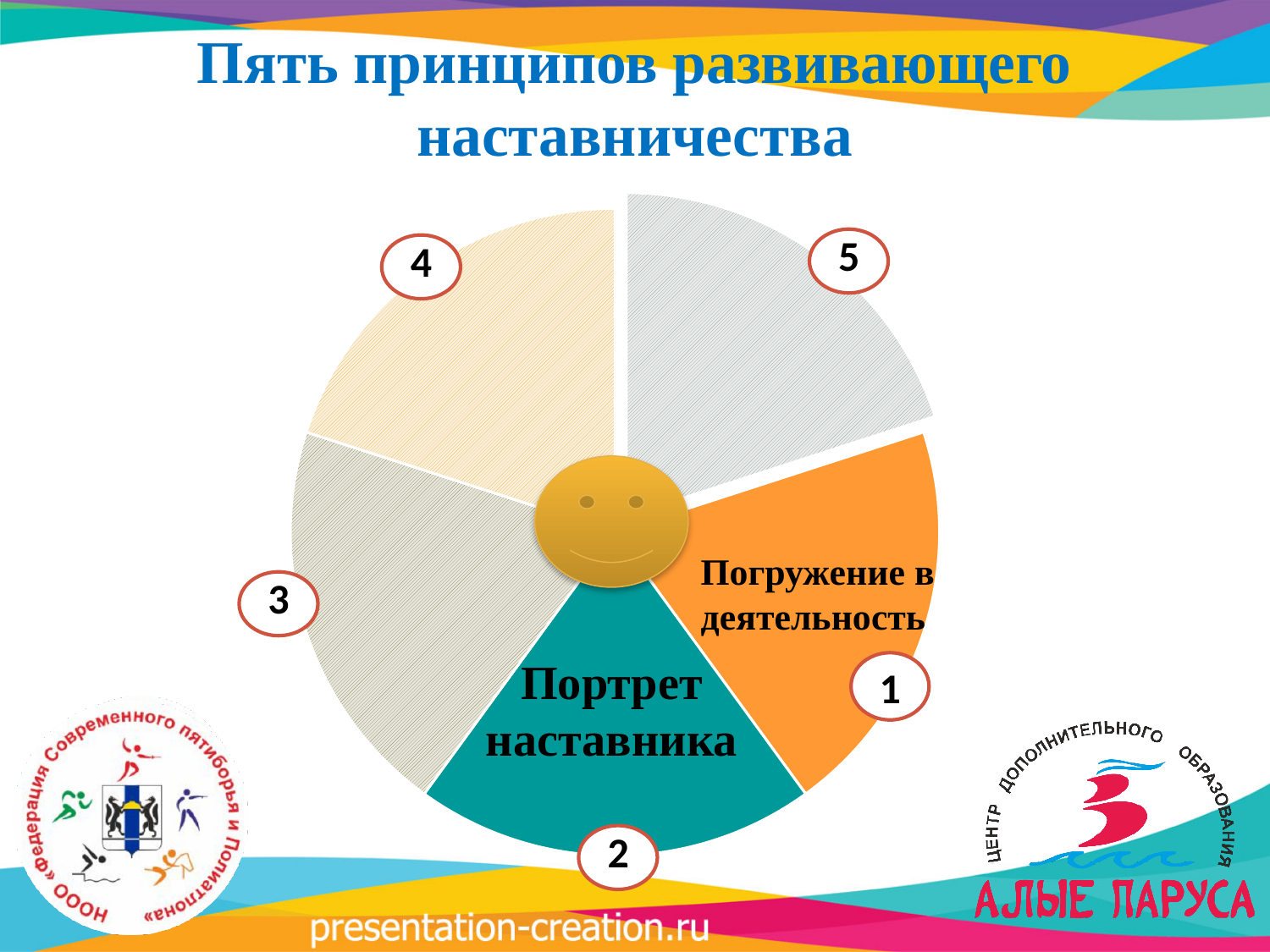
Which number is attached to the slice labelled "Погружение в деятельность"? 1 How many slices of the pie chart carry a text label (other than a number)? 2 Which number is attached to the slice labelled "Портрет наставника"? 2 What kind of chart is shown on the slide? pie chart What is the title of the slide above the pie chart? Пять принципов развивающего наставничества What colour is the slice labelled "Погружение в деятельность"? orange How many slices does the pie chart have? 5